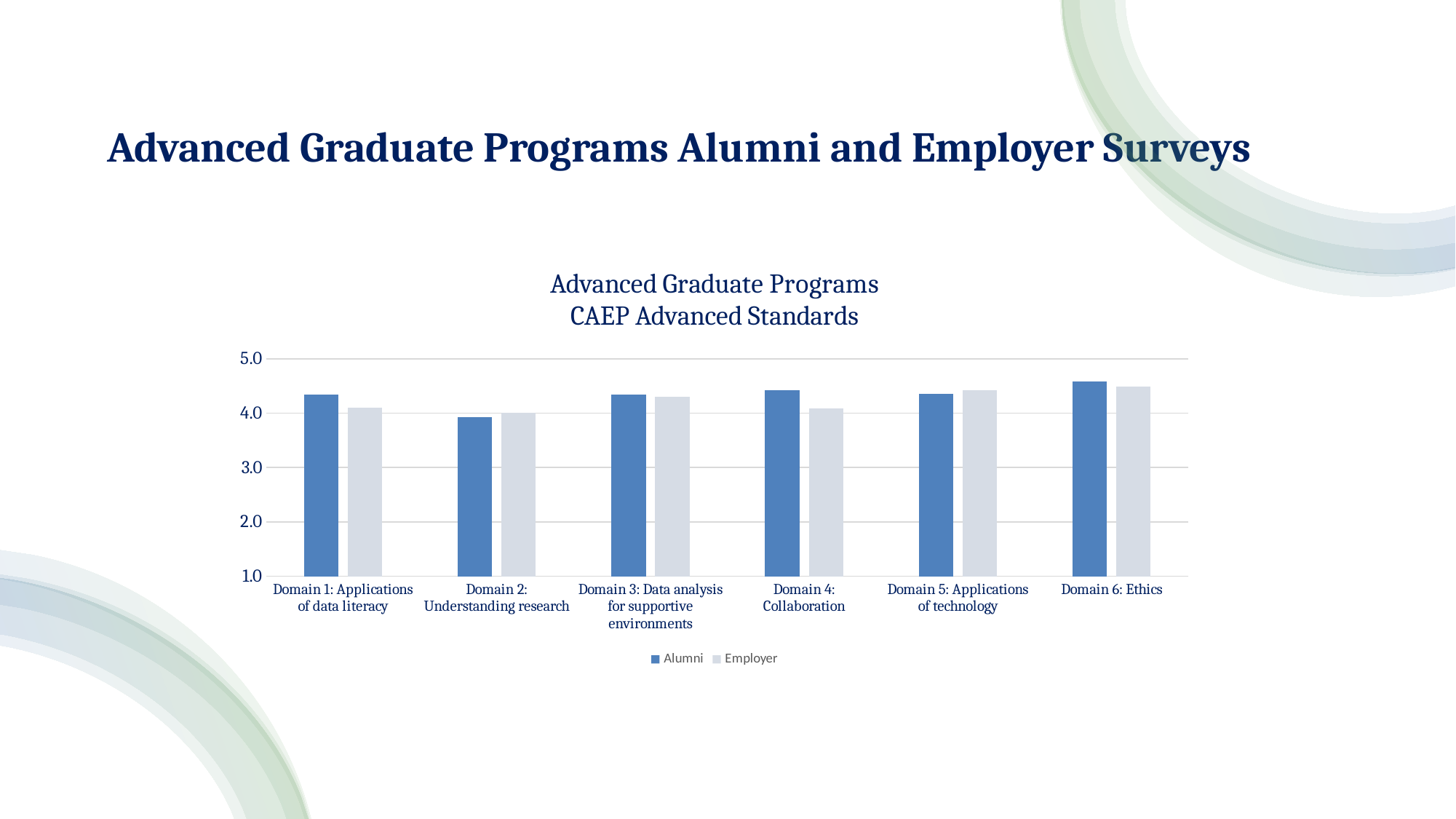
Which domain has the lowest Alumni value? Domain 2: Understanding research For Domain 4: Collaboration, which is larger, the Alumni value or the Employer value? Alumni Is the Alumni value for Domain 6: Ethics greater or less than 5.0? less What is the title of the chart? Advanced Graduate Programs CAEP Advanced Standards For Domain 1: Applications of data literacy, which is larger, the Alumni value or the Employer value? Alumni What are the two series named in the chart's legend? Alumni and Employer How many series does the chart's legend list? 2 Which domain has the highest Alumni value? Domain 6: Ethics Is the Employer value for Domain 1: Applications of data literacy greater or less than 4.0? greater Is the Alumni value for Domain 2: Understanding research greater or less than 4.0? less How many domains (categories) are shown on the x axis of the chart? 6 What kind of chart is shown on the slide? bar chart